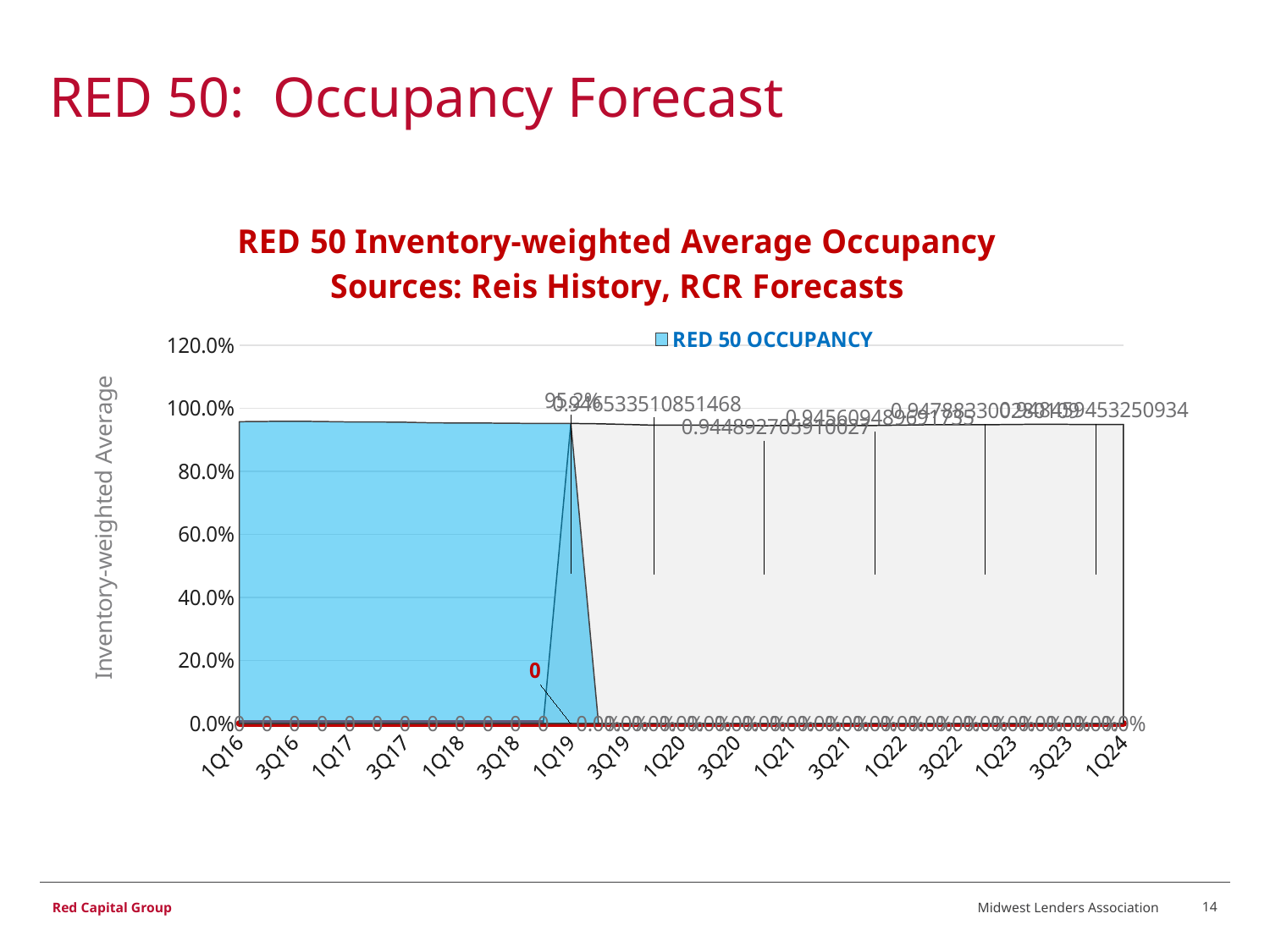
Is the value for 1Q17 greater or less than 80%? greater How many period labels are shown along the x axis? 17 Is the value for 1Q16 greater or less than 40%? greater Is the value for 3Q22 greater or less than 100%? less What is the first period label on the x axis? 1Q16 What is the title of the chart? RED 50 Inventory-weighted Average Occupancy Sources: Reis History, RCR Forecasts How many series does the chart legend list? 1 What kind of chart is shown on the slide? area chart What is the name of the series shown in the chart legend? RED 50 OCCUPANCY What is the last period label on the x axis? 1Q24 What is the highest tick value shown on the y axis? 120.0%